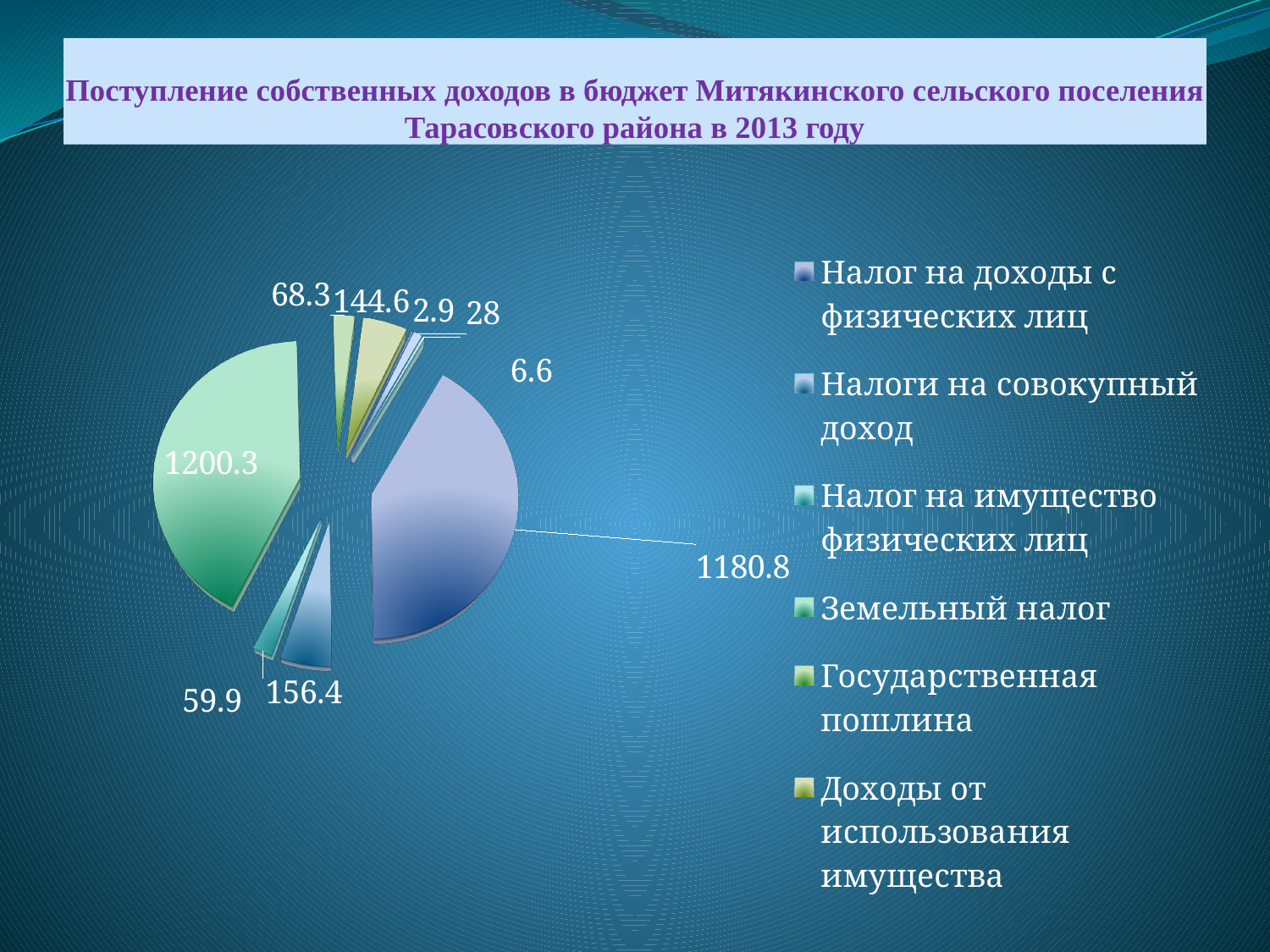
What is the value of the slice for 'Налог на доходы с физических лиц' (the large blue slice)? 1180.8 What is the smallest value labelled on the pie chart? 2.9 Which is larger, the slice labelled 1180.8 or the slice labelled 1200.3? 1200.3 What is the largest value labelled on the pie chart? 1200.3 What kind of chart is shown on the slide? pie chart Which is larger, the slice labelled 68.3 or the slice labelled 144.6? 144.6 What is the first entry listed in the chart's legend? Налог на доходы с физических лиц How many entries are visible in the chart's legend? 6 What is the difference between the slices labelled 1200.3 and 1180.8? 19.5 How many slices with data labels does the pie chart have? 9 What is the difference between the slices labelled 156.4 and 59.9? 96.5 What is the value of the slice for 'Земельный налог' (the large green slice)? 1200.3